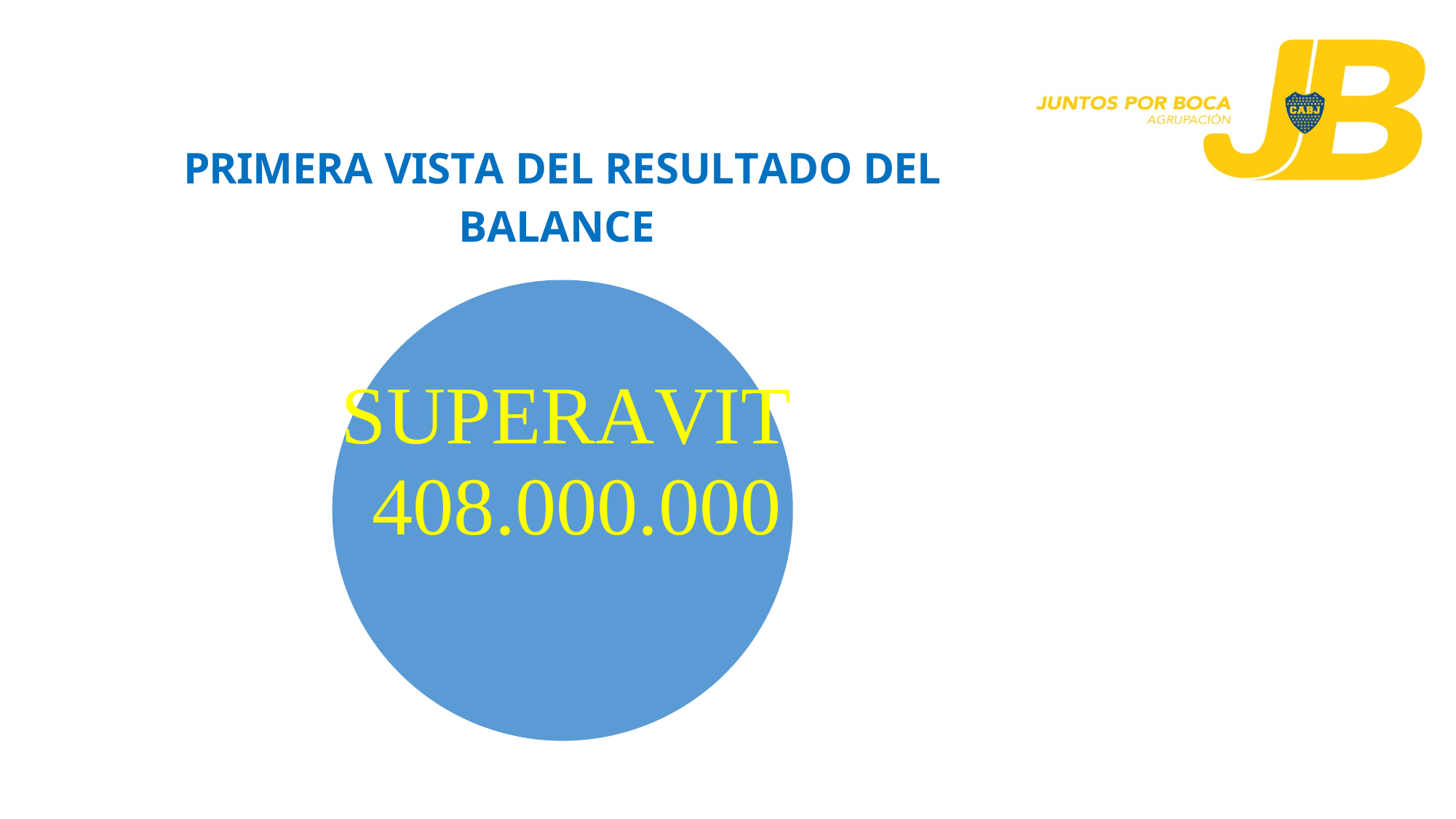
What value is printed on the SUPERAVIT slice of the pie chart? 408.000.000 What is the title shown above the chart? PRIMERA VISTA DEL RESULTADO DEL BALANCE What share of the pie does the SUPERAVIT slice represent? 100% How many slices does the pie chart have? 1 What label is printed on the single slice of the pie chart? SUPERAVIT What kind of chart is shown on the slide? pie chart What colour is the pie chart's slice? blue